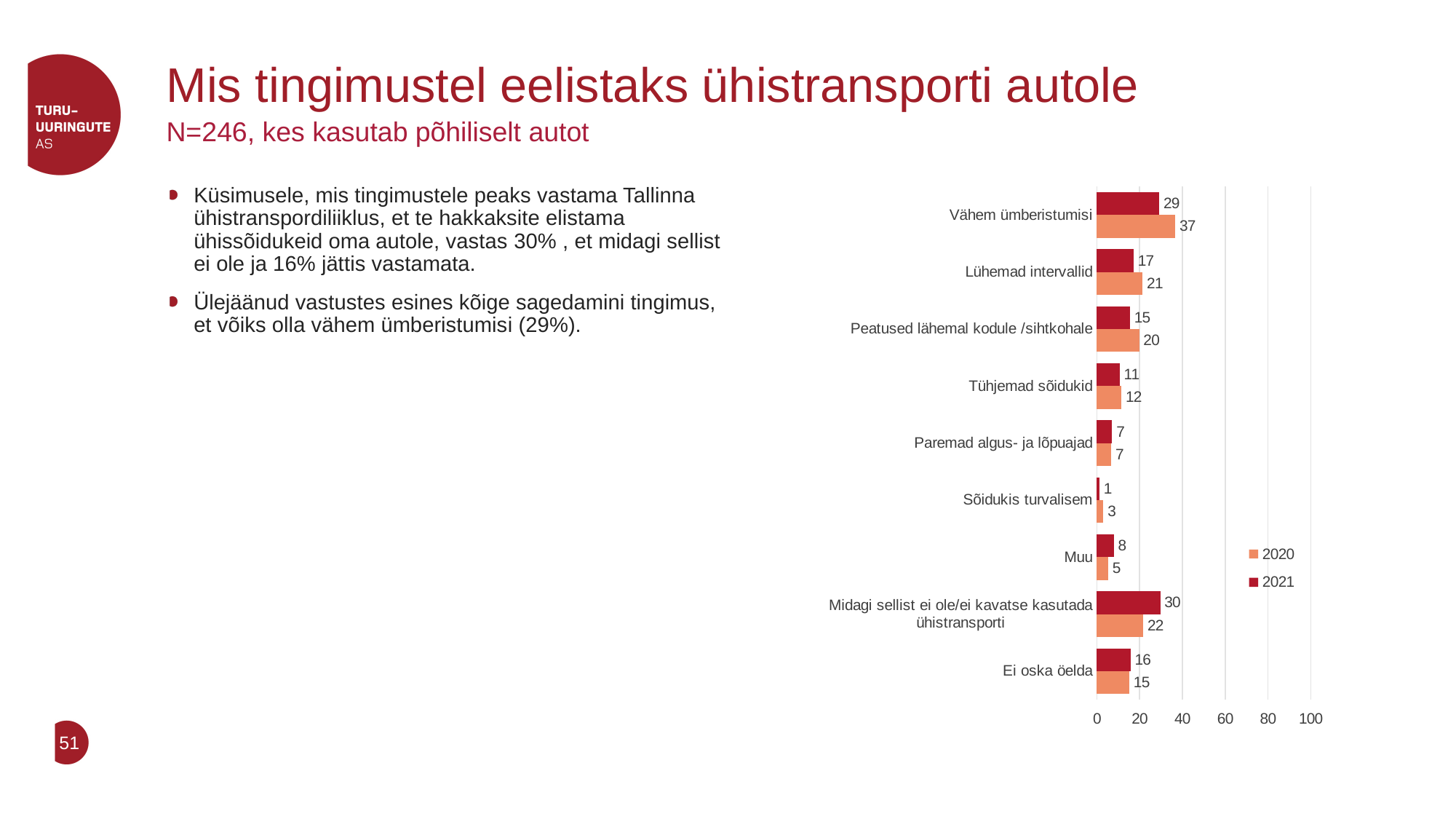
What is the 2020 value for "Vähem ümberistumisi"? 37 Which series is shown in orange in the legend? 2020 Which is larger for "Muu": the 2020 value or the 2021 value? 2021 What is the 2021 value for "Midagi sellist ei ole/ei kavatse kasutada ühistransporti"? 30 Is the 2021 value for "Midagi sellist ei ole/ei kavatse kasutada ühistransporti" greater or less than 20? greater Which category has the highest 2020 value? Vähem ümberistumisi How many series does the legend list? 2 How many categories are shown in the chart? 9 What is the 2021 value for "Lühemad intervallid"? 17 What is the difference between the 2020 and 2021 values for "Vähem ümberistumisi"? 8 Which category has the lowest 2021 value? Sõidukis turvalisem What kind of chart is shown on the slide? Bar chart